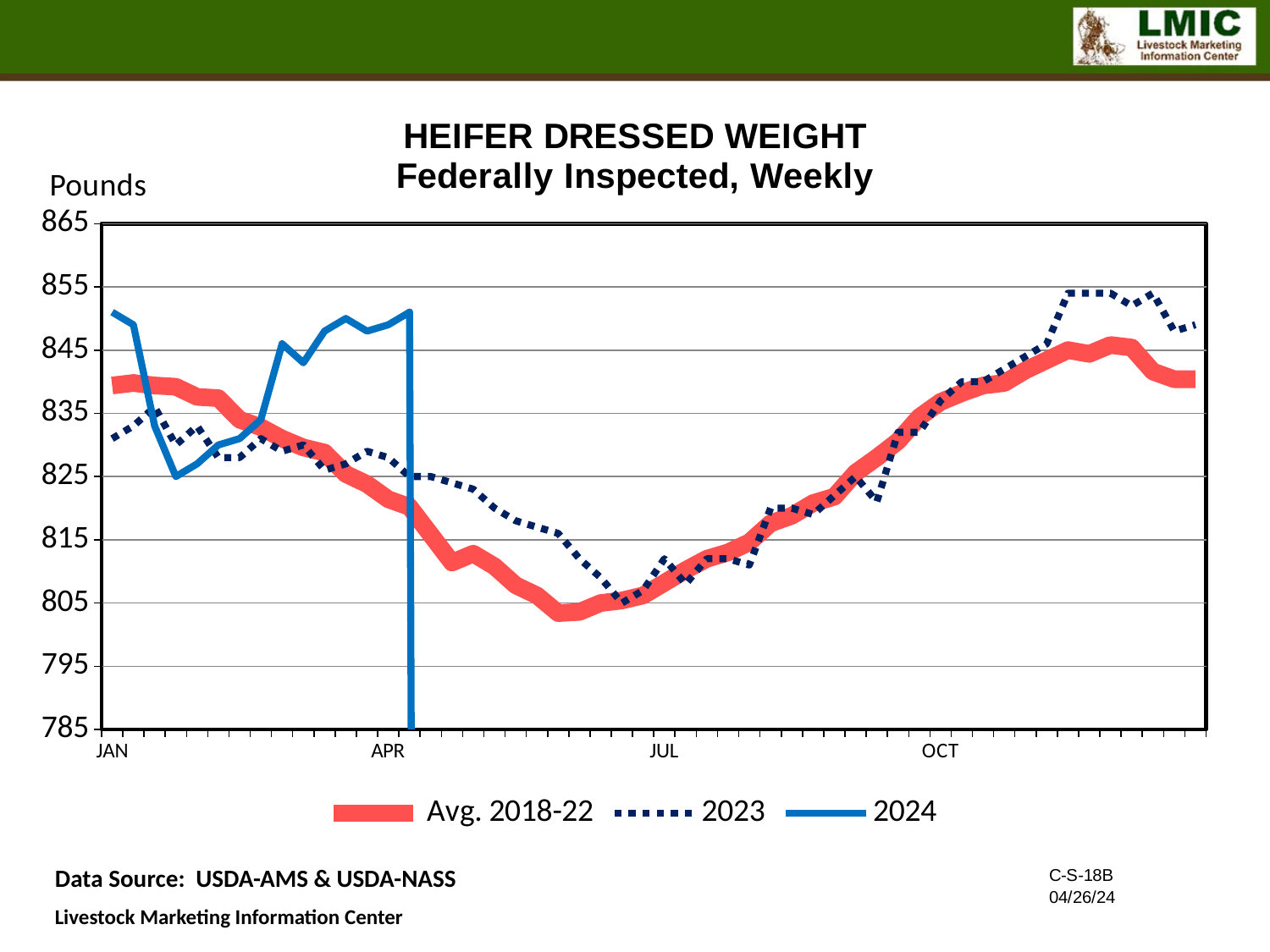
What kind of chart is shown on the slide? line chart Is the value of the 2024 line at the start of JAN greater or less than 845? greater How many series does the legend list? 3 Does the Avg. 2018-22 line rise or fall from JUL to OCT? rise Around APR, which series is higher: 2024 or Avg. 2018-22? 2024 Is the value of the 2023 line at the start of JAN greater or less than 825? greater What unit is shown on the vertical axis label? Pounds What is the title of the chart? HEIFER DRESSED WEIGHT Federally Inspected, Weekly Is the lowest point of the Avg. 2018-22 line greater or less than 815? less At the start of JAN, which series is higher: 2024 or 2023? 2024 Does the Avg. 2018-22 line rise or fall from JAN to JUL? fall